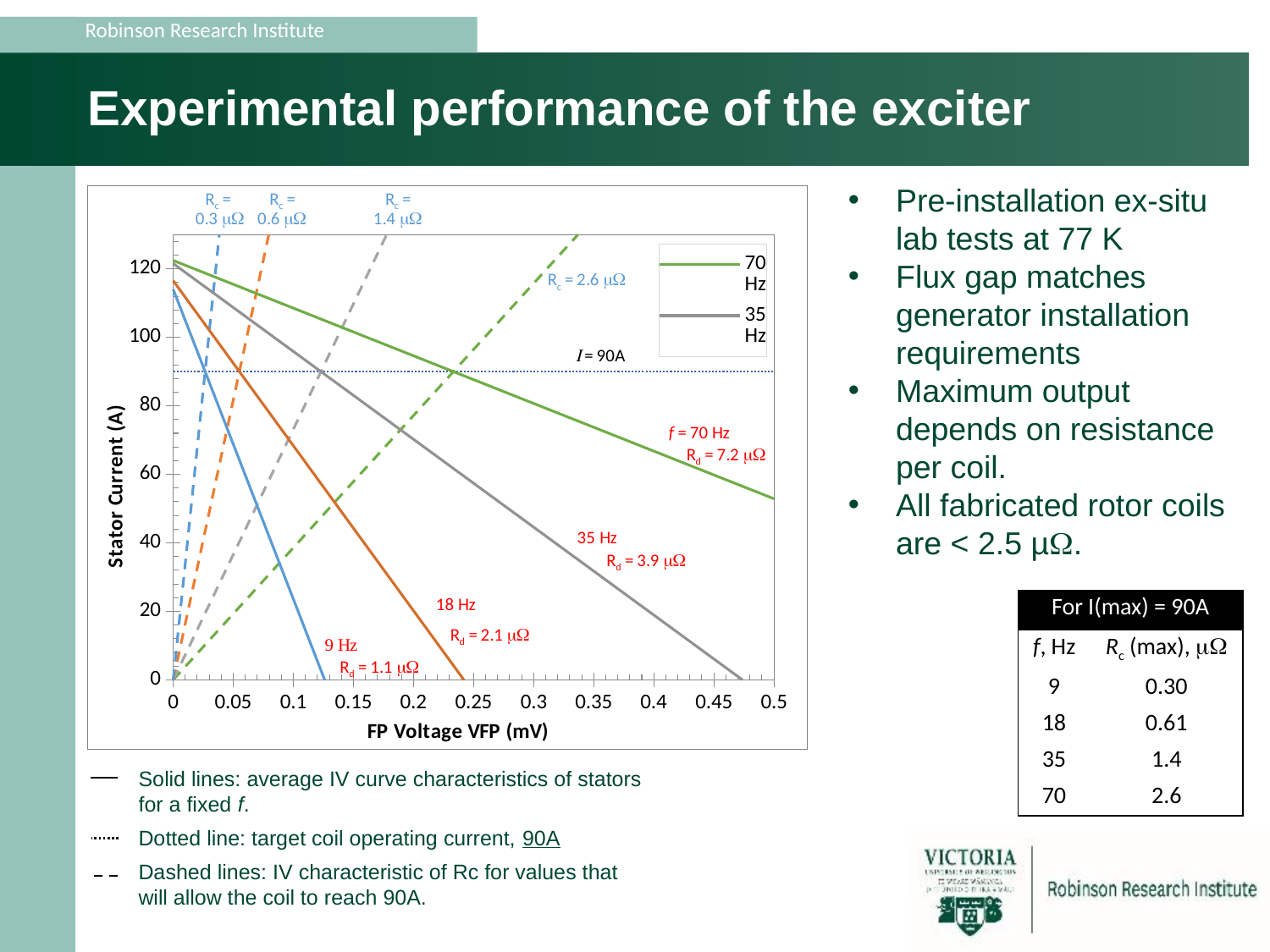
Do the solid lines in the chart rise or fall as FP Voltage increases? fall What R_d value is printed next to the 35 Hz solid line? 3.9 μΩ Is the stator current of the 70 Hz solid line at 0.5 mV greater or less than 60? less What R_c value is printed next to the green dashed line? 2.6 μΩ Which solid line reaches zero stator current at the lowest FP voltage? 9 Hz How many entries does the chart's legend list? 2 What kind of chart is shown on the slide? line chart What is the title of the slide containing the chart? Experimental performance of the exciter What R_d value is printed next to the f = 70 Hz solid line? 7.2 μΩ What R_d value is printed next to the 9 Hz solid line? 1.1 μΩ What is the label of the chart's y axis? Stator Current (A) What current value does the dotted horizontal line in the chart mark? 90A